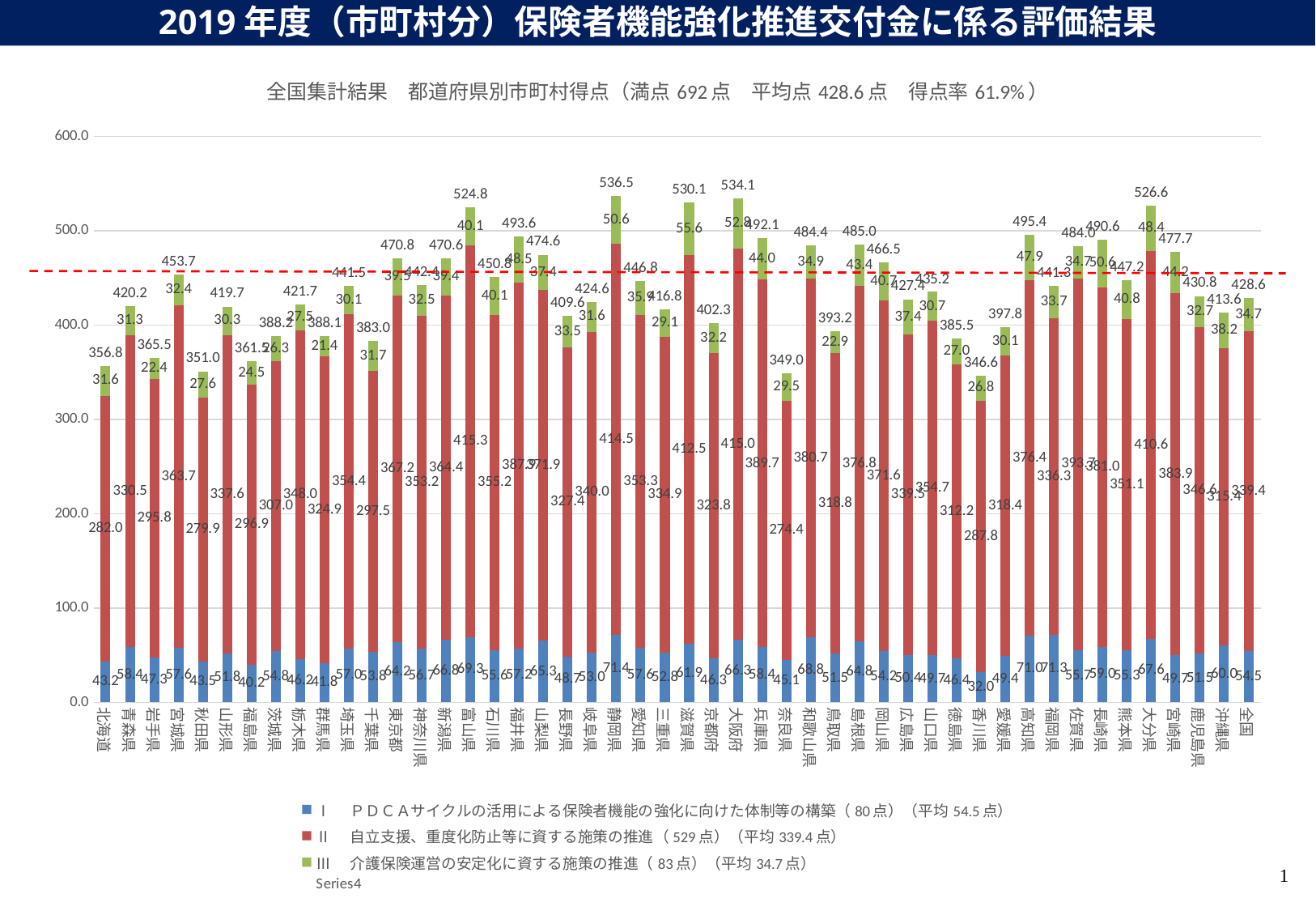
What is the difference between the 全国 total score and the 北海道 total score? 71.8 What is the 満点 (maximum possible score) stated in the chart title? 692 点 What is the total score shown for 北海道? 356.8 What is the difference between the total scores of 静岡県 and 大阪府? 2.4 Which has a higher total score, 富山県 or 東京都? 富山県 What is the value of the II (red) segment for 全国? 339.4 What is the value of the I (blue) segment for 富山県? 69.3 What kind of chart is shown on the slide? Stacked bar chart What is the value of the III (green) segment for 静岡県? 50.6 What is the 平均点 (average score) stated in the chart title? 428.6 点 How many bars are plotted in the chart? 48 Which prefecture has the highest total score? 静岡県